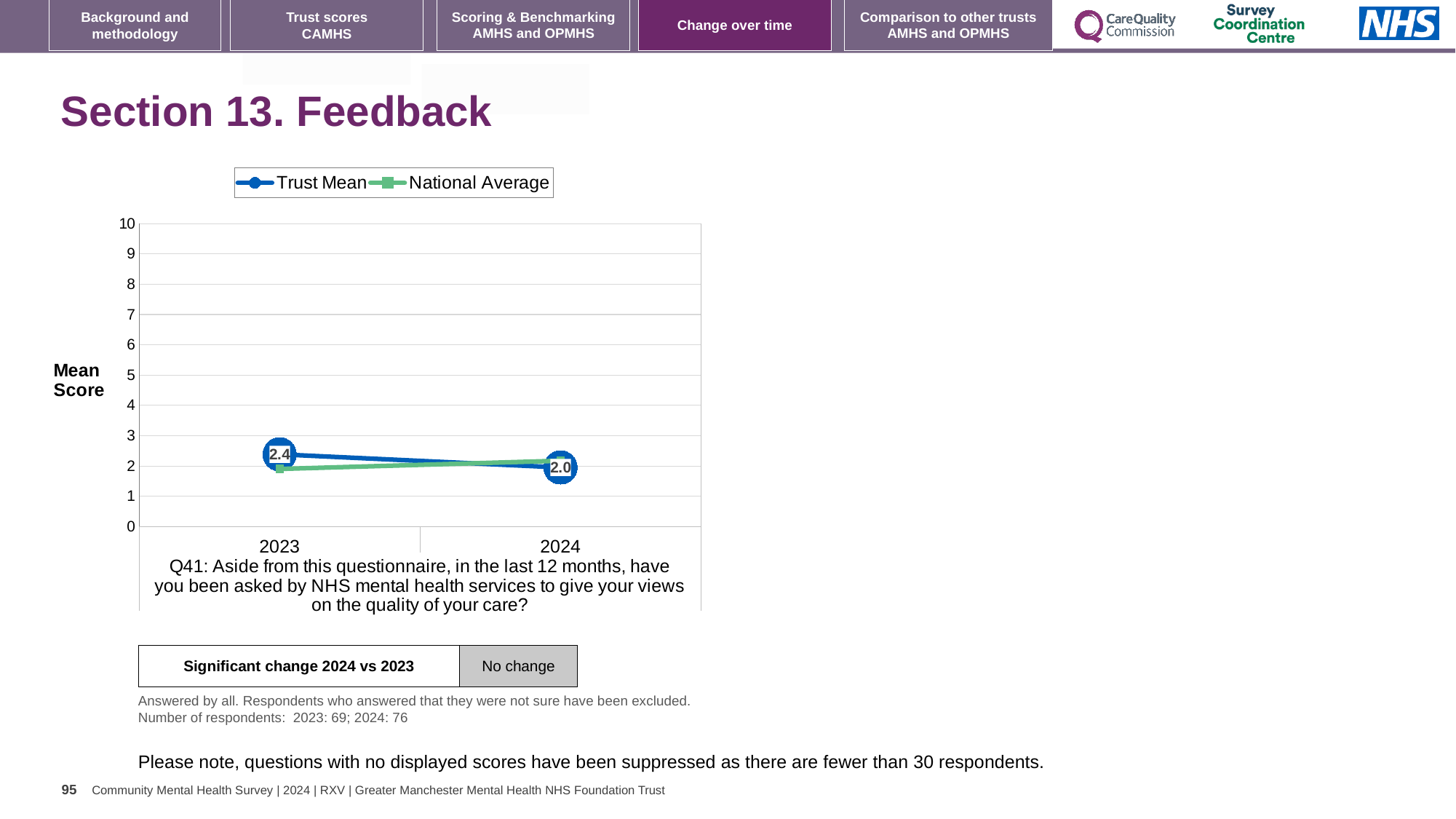
How many series does the legend list? 2 Does the Trust Mean rise or fall from 2023 to 2024? fall In 2023, which is larger, the Trust Mean or the National Average? Trust Mean What is the label on the y axis of the chart? Mean Score By how much did the Trust Mean change from 2023 to 2024? 0.4 How many years are plotted on the x axis? 2 What is the Trust Mean value for 2024? 2.0 What is the Trust Mean value for 2023? 2.4 Is the Trust Mean value for 2023 greater or less than 3? less What kind of chart is shown on the slide? line chart Which year has the higher Trust Mean, 2023 or 2024? 2023 Is the National Average value for 2024 greater or less than 3? less